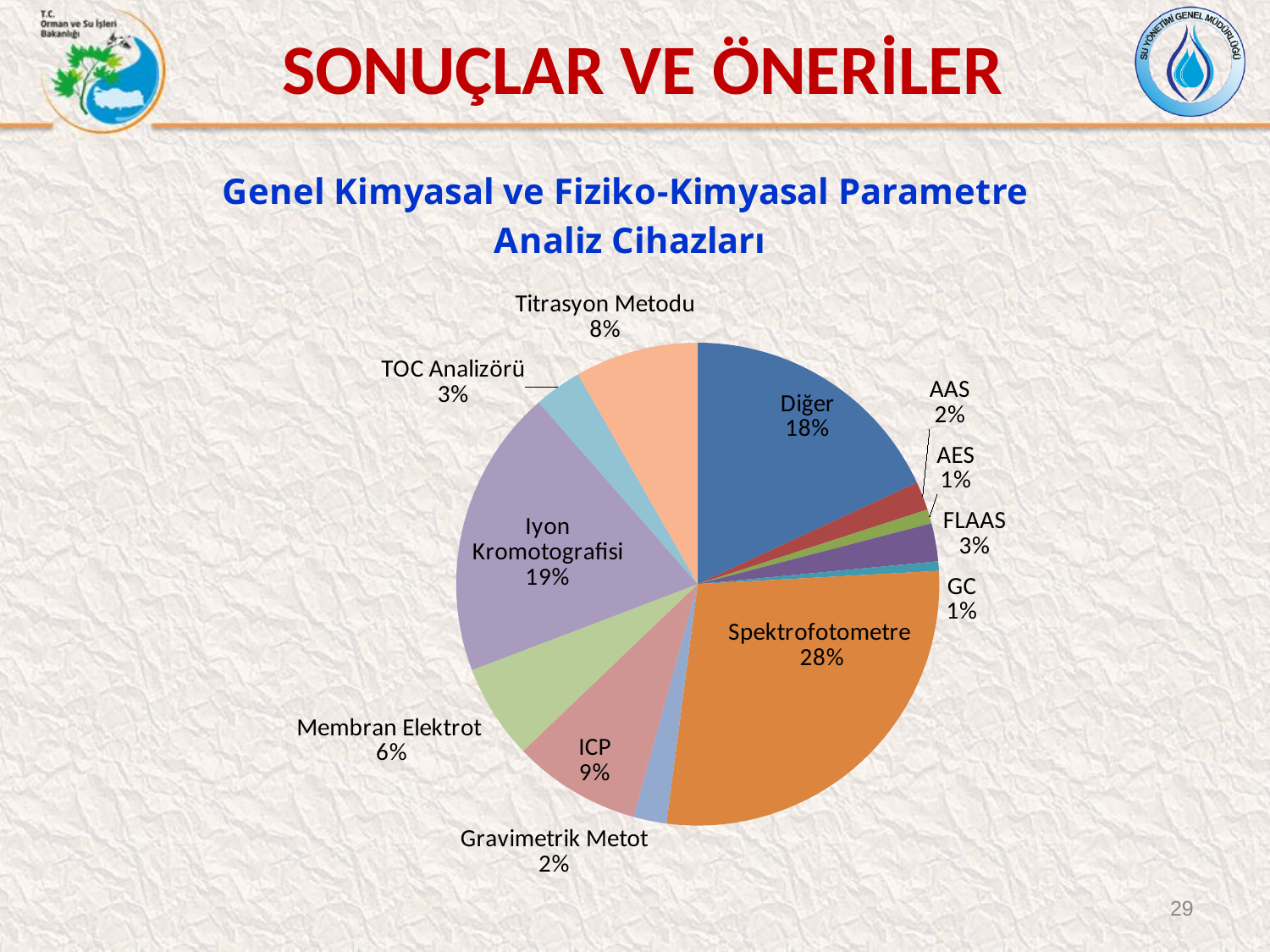
How many categories are shown in the pie chart? 12 What is the difference between the shares of Iyon Kromotografisi and Titrasyon Metodu? 11% What is the title of the chart? Genel Kimyasal ve Fiziko-Kimyasal Parametre Analiz Cihazları Which category has the largest slice of the pie? Spektrofotometre What share of the pie does Spektrofotometre have? 28% What is the difference between the shares of Spektrofotometre and Diğer? 10% What is the value shown for Titrasyon Metodu? 8% Which is larger, the share for ICP or the share for Membran Elektrot? ICP What is the value shown for FLAAS? 3% What is the value shown for Membran Elektrot? 6% What kind of chart is shown on the slide? pie chart What share of the pie does Iyon Kromotografisi have? 19%